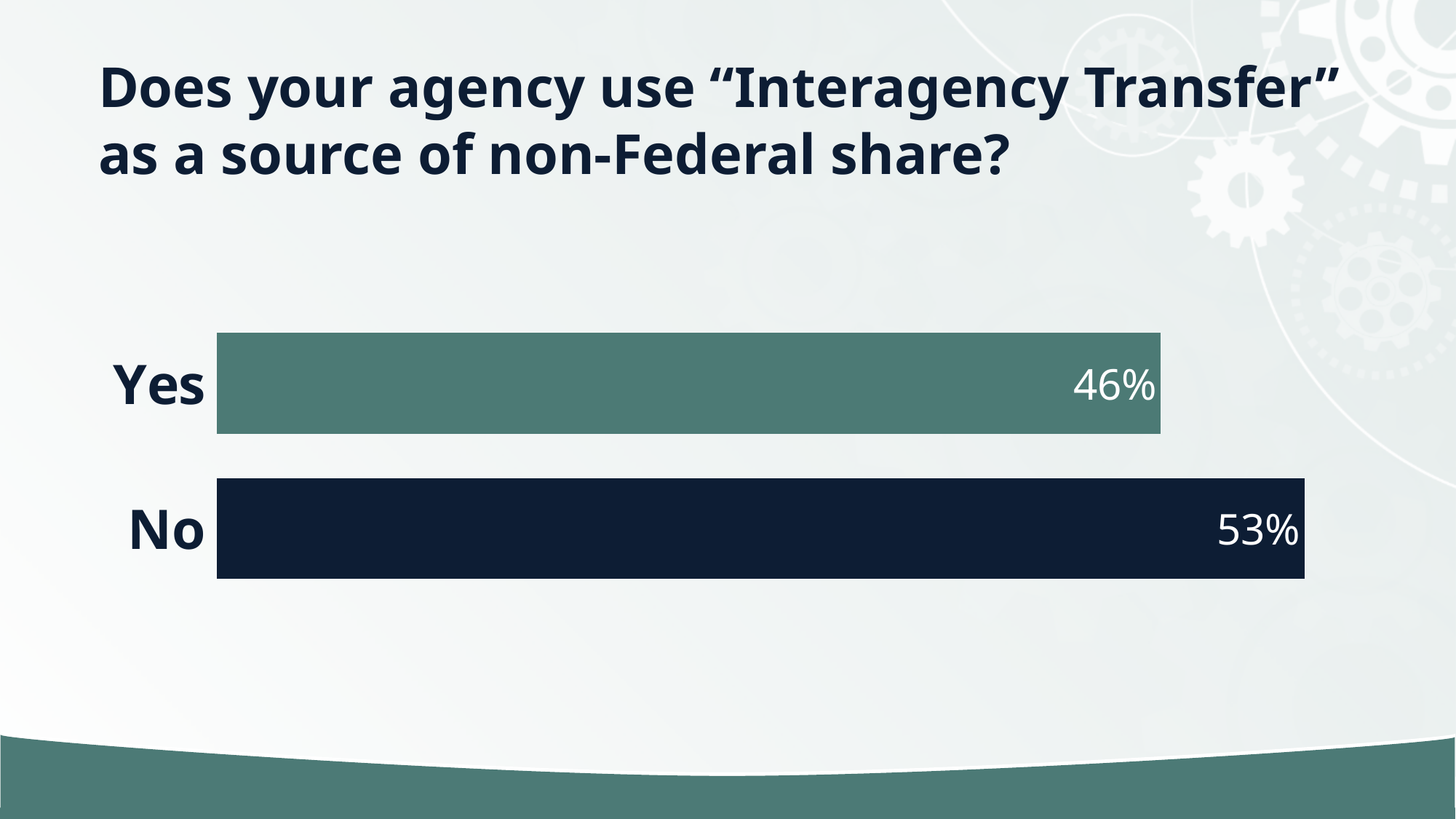
What percentage of respondents answered Yes? 46% How many response categories are shown in the chart? 2 What is the combined percentage of the Yes and No responses? 99% What is the difference in percentage points between the No and Yes responses? 7 Which response has the higher percentage, Yes or No? No Is the value for Yes larger or smaller than the value for No? smaller What question does the chart title ask? Does your agency use "Interagency Transfer" as a source of non-Federal share? What colour is the bar for the No response? dark navy What percentage of respondents answered No? 53% Which response has the lower percentage? Yes What type of chart is shown on the slide? bar chart